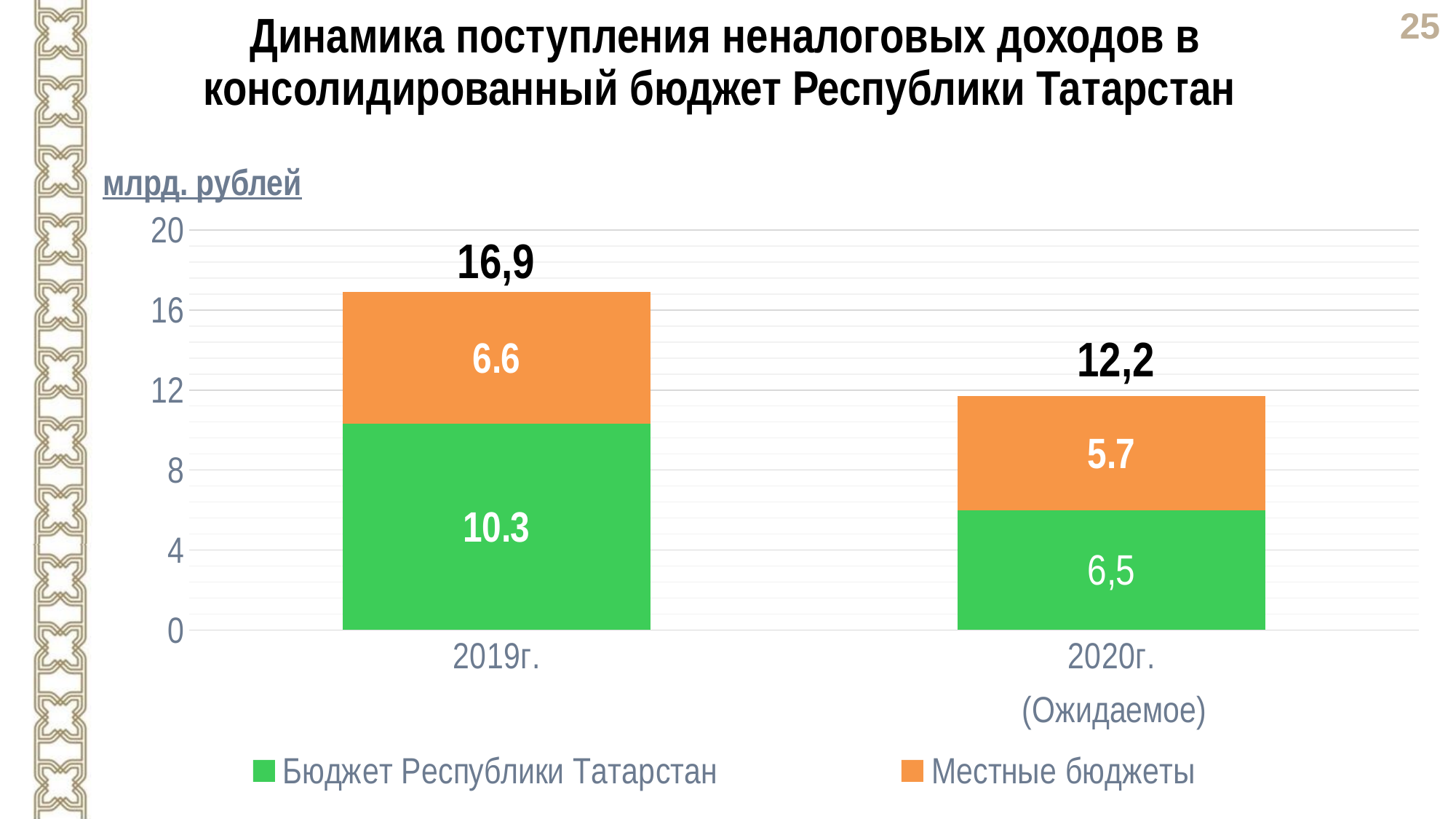
What type of chart is shown on the slide? Stacked bar chart What is the value for Бюджет Республики Татарстан in 2020г. (Ожидаемое)? 6,5 What is the value for Бюджет Республики Татарстан in 2019г.? 10.3 What is the total of the stacked bar for 2020г. (Ожидаемое)? 12,2 How many series does the legend list? 2 Do the total values rise or fall from 2019г. to 2020г. (Ожидаемое)? Fall Which year has the higher total non-tax revenue? 2019г. What unit of measurement is indicated for the chart? млрд. рублей What is the difference between the Бюджет Республики Татарстан values for 2019г. and 2020г. (Ожидаемое)? 3.8 What is the value for Местные бюджеты in 2020г. (Ожидаемое)? 5.7 What is the total of the stacked bar for 2019г.? 16,9 What is the value for Местные бюджеты in 2019г.? 6.6